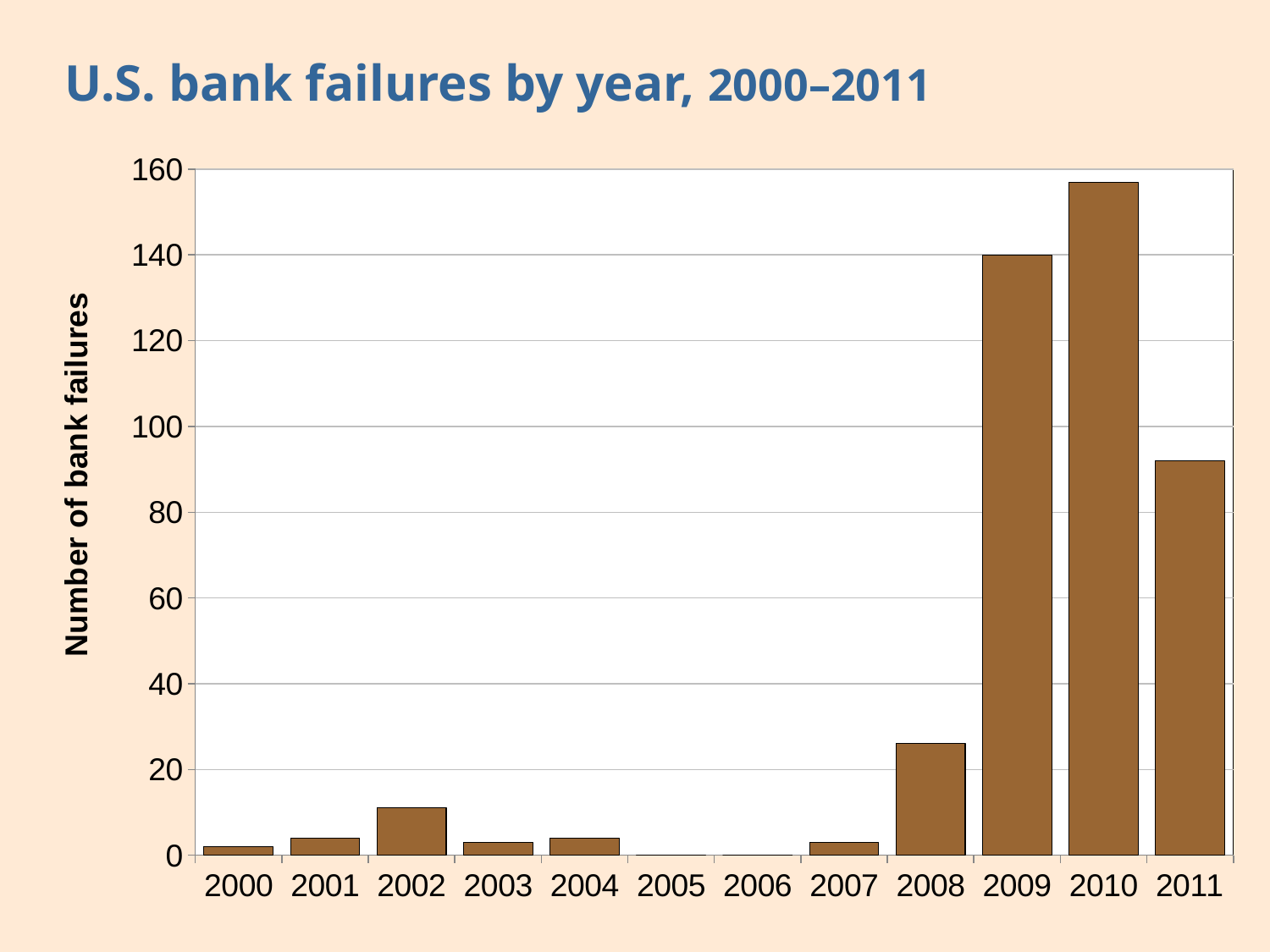
What kind of chart is shown on the slide? bar chart Is the value for 2008 greater or less than 20? greater Which year has the highest number of bank failures? 2010 Do the values rise or fall from 2008 to 2010? rise Is the value for 2002 greater or less than 20? less Which year has more bank failures, 2009 or 2011? 2009 What is the number of bank failures for 2005? 0 What is the label on the y axis of the chart? Number of bank failures How many years are shown on the x axis of the chart? 12 What is the number of bank failures for 2009? 140 Is the value for 2010 greater or less than 140? greater